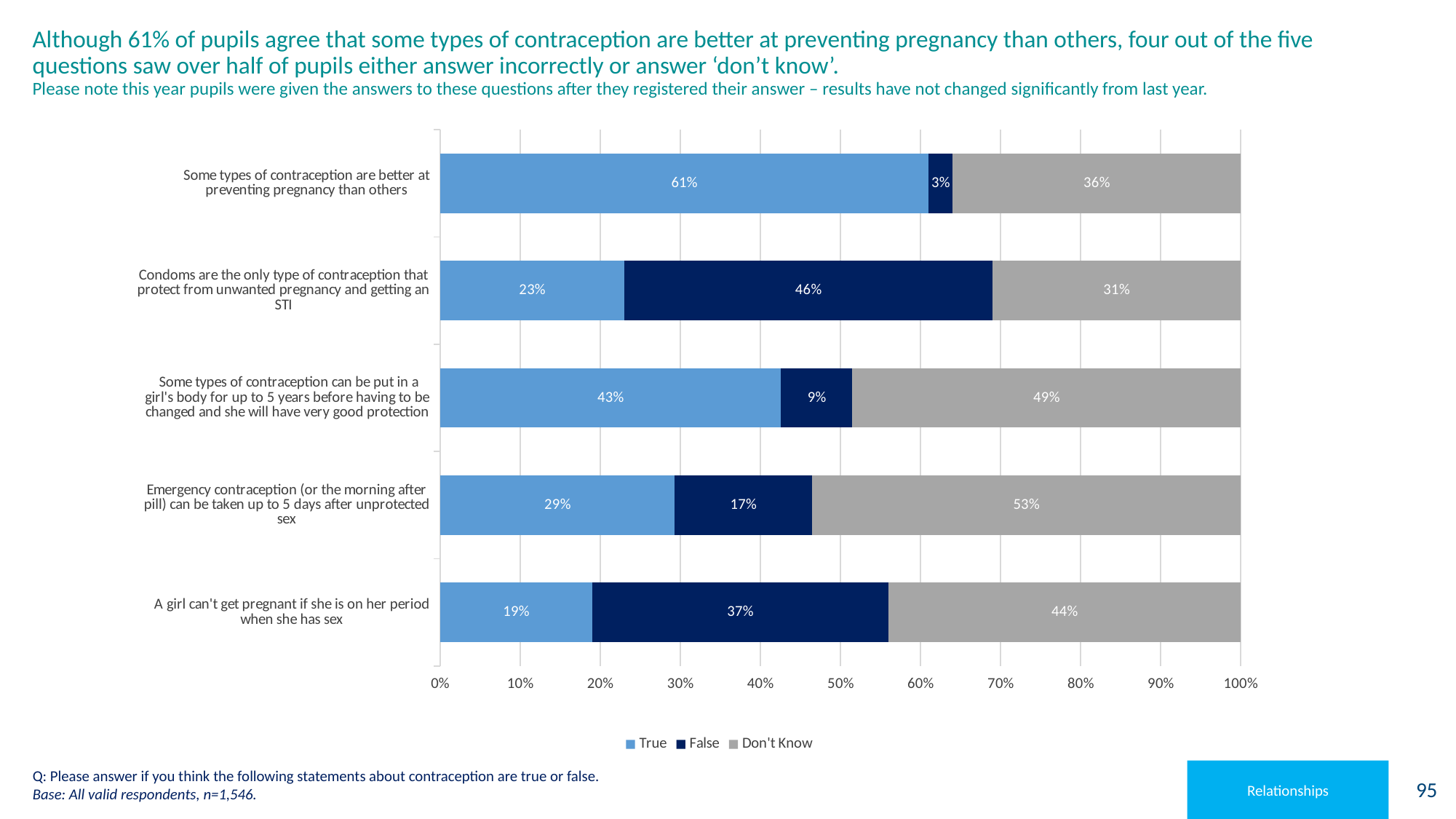
How many statements are shown in the chart? 5 What percentage of pupils answered 'True' to the statement 'Some types of contraception are better at preventing pregnancy than others'? 61% What percentage of pupils answered 'Don't Know' to the statement 'Emergency contraception (or the morning after pill) can be taken up to 5 days after unprotected sex'? 53% Which statement has the lowest 'False' percentage? Some types of contraception are better at preventing pregnancy than others How many series does the legend list? 3 What is the combined percentage of 'False' and 'Don't Know' answers for the statement 'Emergency contraception (or the morning after pill) can be taken up to 5 days after unprotected sex'? 70% What is the difference between the 'Don't Know' percentage and the 'True' percentage for the statement 'A girl can't get pregnant if she is on her period when she has sex'? 25% Which colour represents the 'Don't Know' series in the chart? Grey What percentage of pupils answered 'False' to the statement 'Condoms are the only type of contraception that protect from unwanted pregnancy and getting an STI'? 46% What kind of chart is shown on the slide? Stacked bar chart Which statement has the highest 'True' percentage? Some types of contraception are better at preventing pregnancy than others For the statement 'Some types of contraception can be put in a girl's body for up to 5 years before having to be changed and she will have very good protection', is the 'True' or 'Don't Know' percentage larger? Don't Know